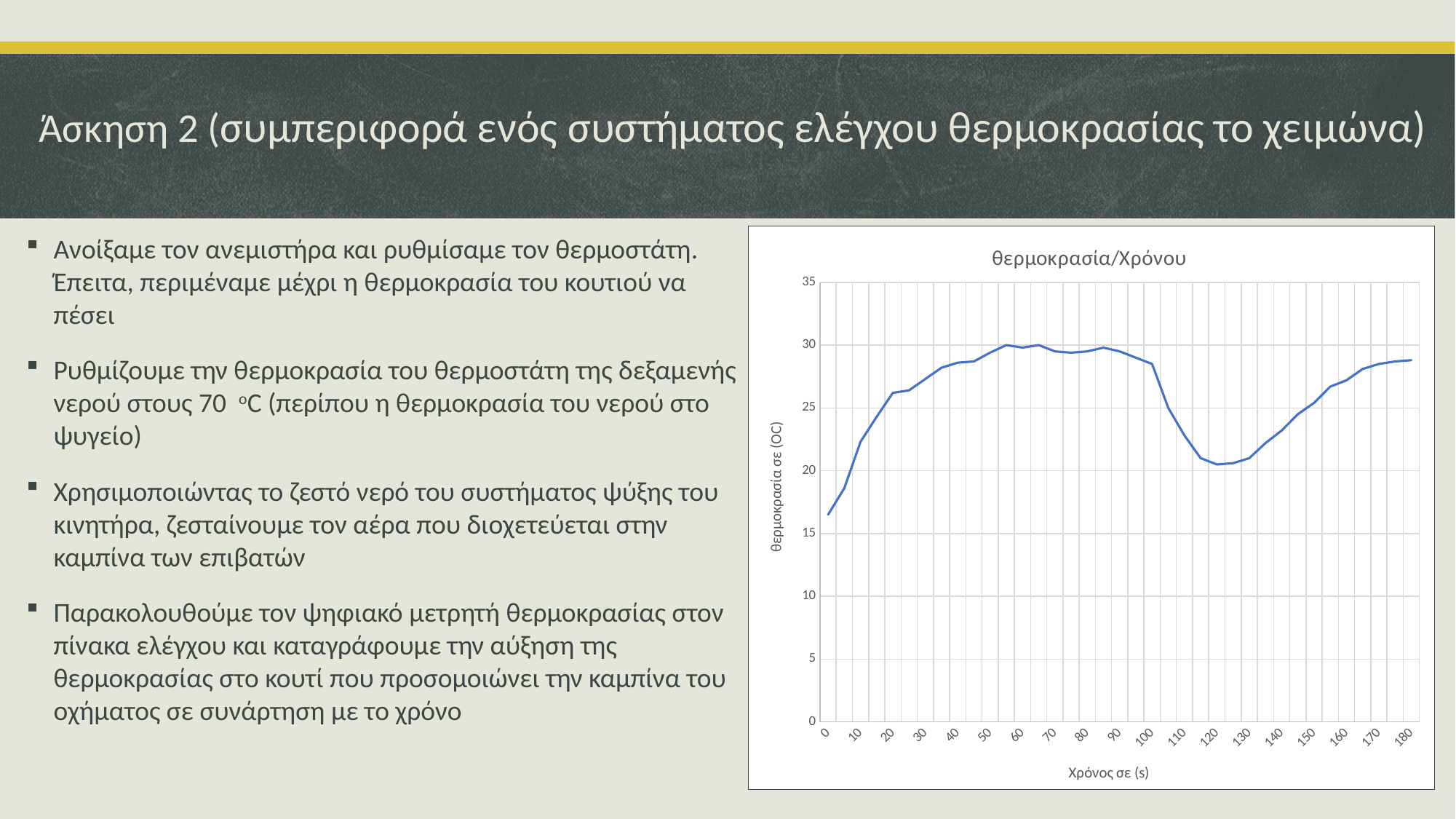
What is the label of the x axis of the chart? Χρόνος σε (s) What kind of chart is shown on the slide? line chart Is the temperature at 60 s greater or less than 25? greater Is the temperature at 0 s greater or less than 15? greater Does the temperature rise or fall between 100 s and 120 s? fall Which is larger, the temperature at 60 s or at 120 s? 60 s Is the temperature at 120 s greater or less than 25? less What is the title of the chart? θερμοκρασία/Χρόνου Does the temperature rise or fall between 0 s and 50 s? rise